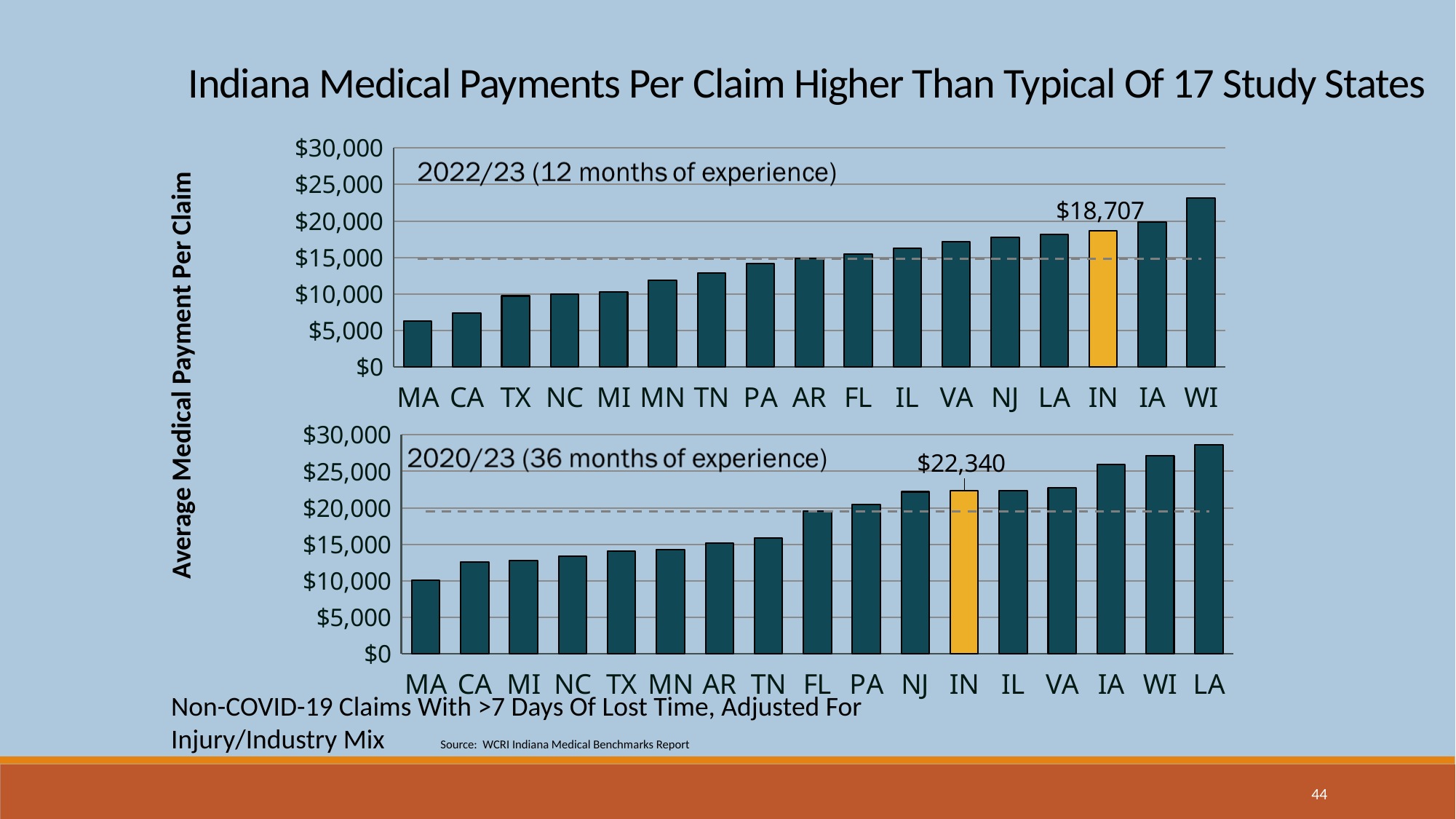
In the 2022/23 (12 months of experience) chart, which state's bar is highlighted in yellow? IN In the 2020/23 (36 months of experience) chart, which state has the lowest average medical payment per claim? MA In the 2022/23 (12 months of experience) chart, which state has the highest average medical payment per claim? WI What type of chart is used in the 2020/23 (36 months of experience) chart? Bar chart In the 2020/23 (36 months of experience) chart, is the value for LA greater or less than $25,000? greater In the 2022/23 (12 months of experience) chart, which state has the lowest average medical payment per claim? MA How many states are shown in the 2022/23 (12 months of experience) chart? 17 How much higher is Indiana's labeled value in the 2020/23 (36 months of experience) chart than in the 2022/23 (12 months of experience) chart? $3,633 In the 2020/23 (36 months of experience) chart, what is the average medical payment per claim for IN? $22,340 In the 2020/23 (36 months of experience) chart, which state has the highest average medical payment per claim? LA In the 2022/23 (12 months of experience) chart, is the value for MA greater or less than $10,000? less In the 2022/23 (12 months of experience) chart, what is the average medical payment per claim for IN? $18,707